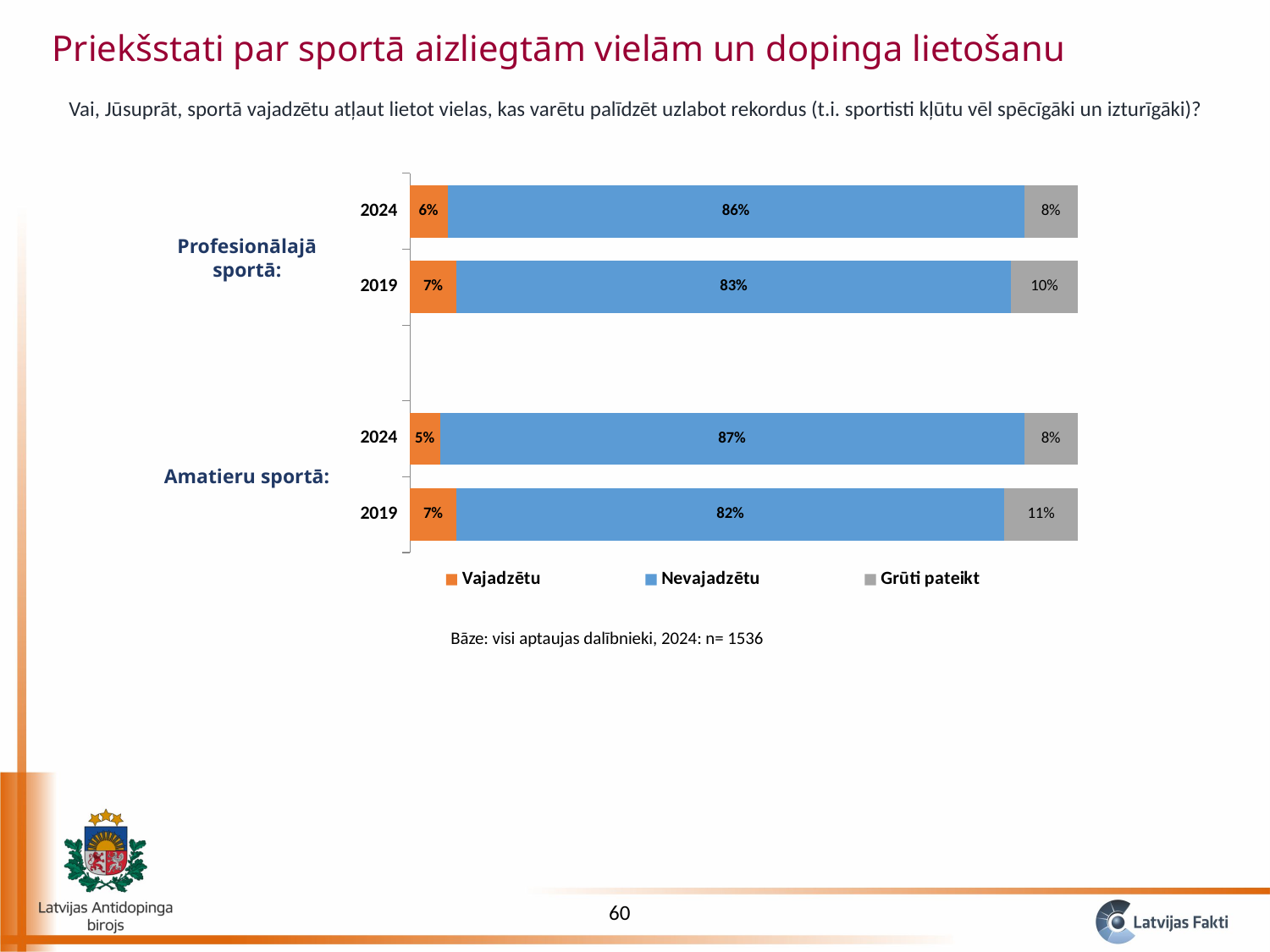
What percentage answered "Grūti pateikt" for Amatieru sportā in 2019? 11% Which bar has the highest "Nevajadzētu" share? Amatieru sportā 2024 What kind of chart is shown on the slide? Stacked bar chart What percentage answered "Nevajadzētu" for Profesionālajā sportā in 2024? 86% Is the "Grūti pateikt" share larger for Amatieru sportā 2019 or Amatieru sportā 2024? Amatieru sportā 2019 What percentage answered "Vajadzētu" for Amatieru sportā in 2019? 7% How many bars are plotted in the chart? 4 What percentage answered "Grūti pateikt" for Profesionālajā sportā in 2019? 10% Which bar has the lowest "Vajadzētu" share? Amatieru sportā 2024 How many series does the legend list? 3 What is the difference in the "Nevajadzētu" share for Profesionālajā sportā between 2024 and 2019? 3 percentage points Which colour represents "Vajadzētu" in the chart? Orange